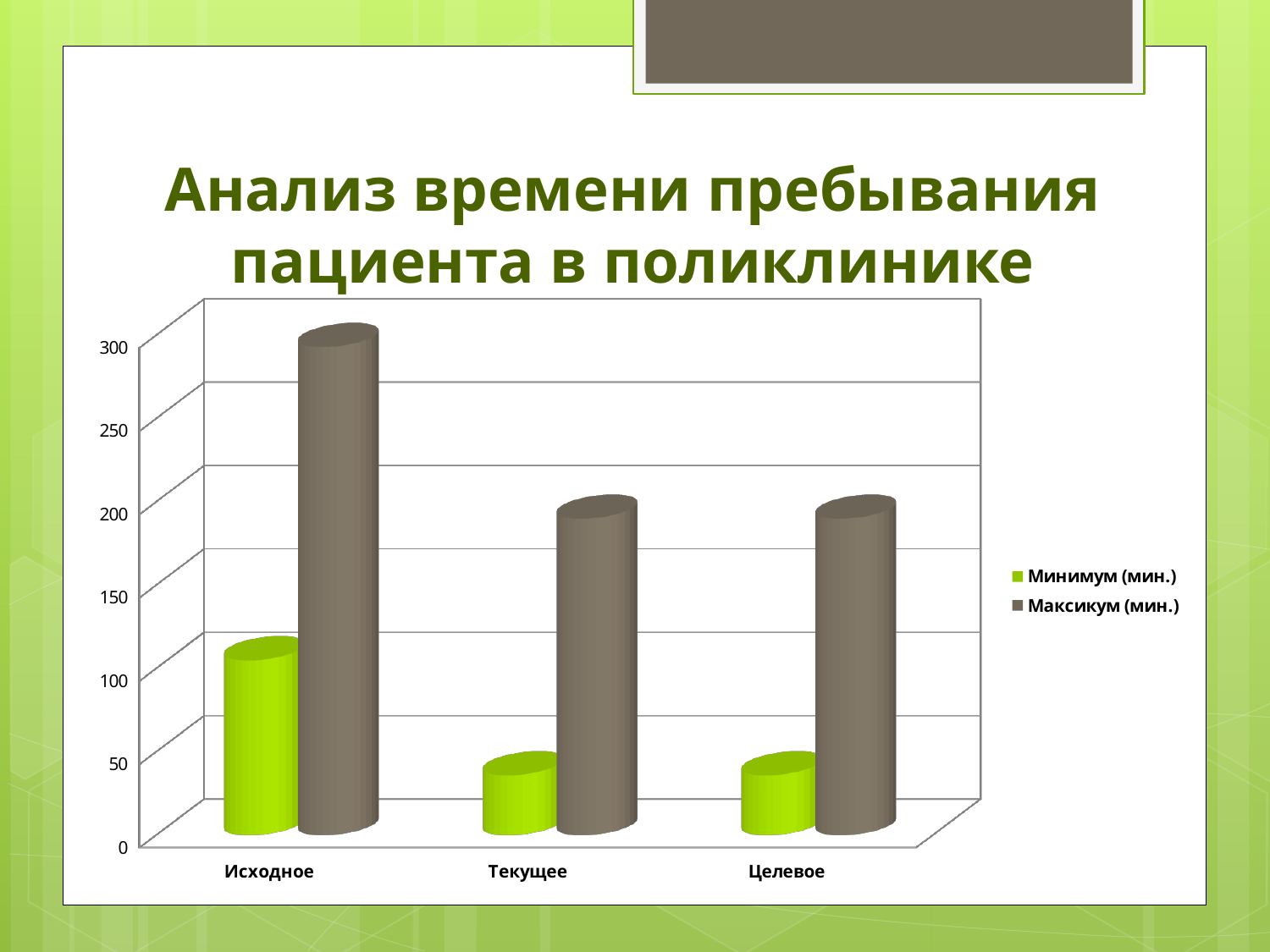
What kind of chart is shown on the slide? bar chart Which category has the highest Максикум (мин.) value? Исходное Is the Минимум (мин.) value for Исходное greater or less than 50? greater How many categories are shown on the x axis of the chart? 3 How many series does the chart legend list? 2 Is the Максикум (мин.) value for Исходное greater or less than 250? greater Is the Максикум (мин.) value for Текущее greater or less than 250? less Which series is shown in green in the chart? Минимум (мин.) What is the title of the slide containing the chart? Анализ времени пребывания пациента в поликлинике Which is larger: the Максикум (мин.) value for Исходное or for Целевое? Исходное Which category has the highest Минимум (мин.) value? Исходное